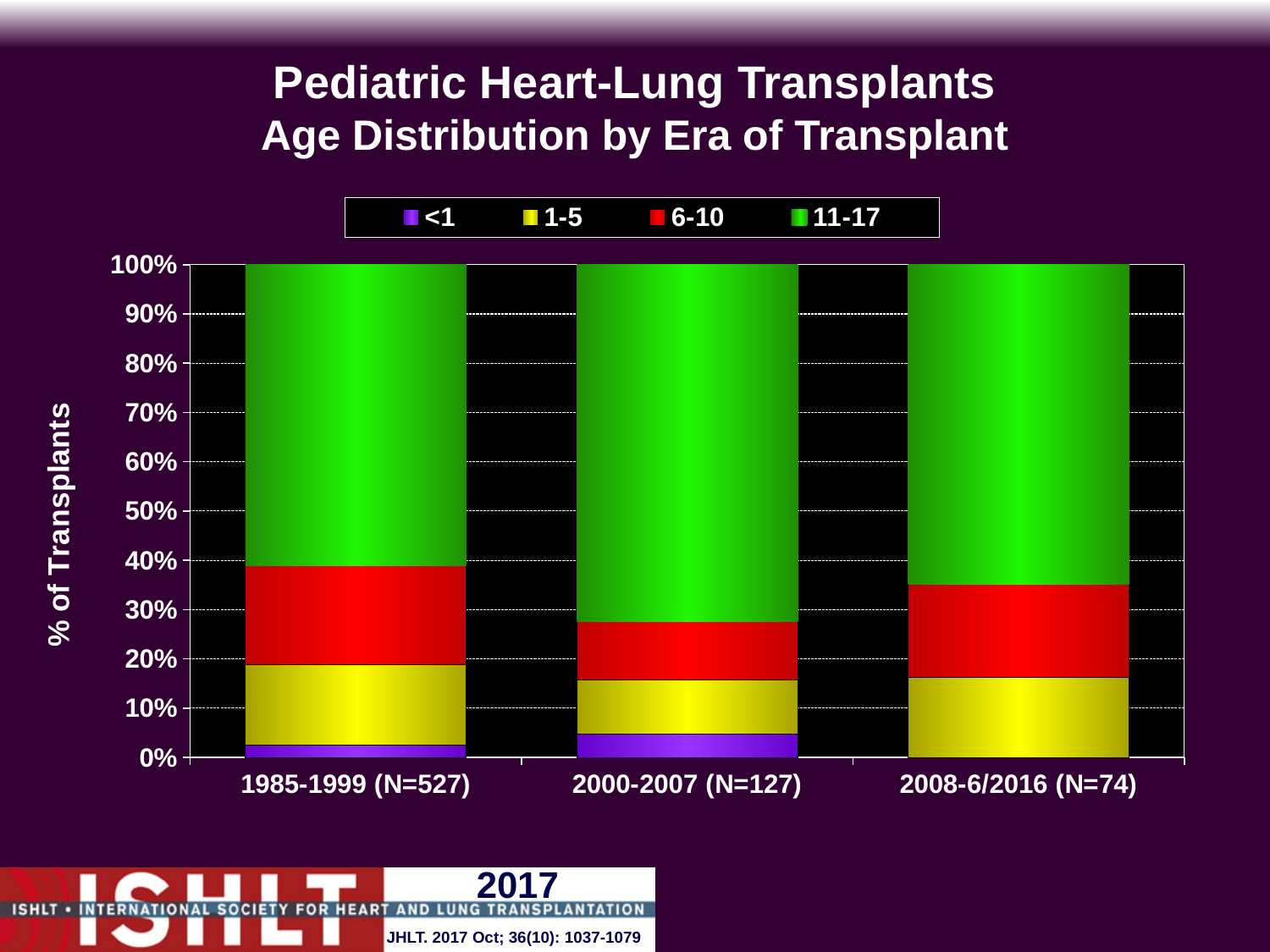
What is the N for the 2000-2007 era? 127 Which era has the smallest share of transplants in the <1 age group? 2008-6/2016 (N=74) How many transplant eras are shown on the x axis? 3 What is the N for the 1985-1999 era? 527 What kind of chart is shown on the slide? Stacked bar chart Is the share of the 11-17 age group in the 2000-2007 era greater or less than 60%? greater How many age groups does the legend list? 4 Is the share of the <1 age group larger in the 1985-1999 era or the 2000-2007 era? 2000-2007 Which age group is shown in green in the legend? 11-17 What is the title of the chart? Pediatric Heart-Lung Transplants Age Distribution by Era of Transplant Is the share of the 6-10 age group in the 1985-1999 era greater or less than 30%? less Which era has the largest share of transplants in the 11-17 age group? 2000-2007 (N=127)